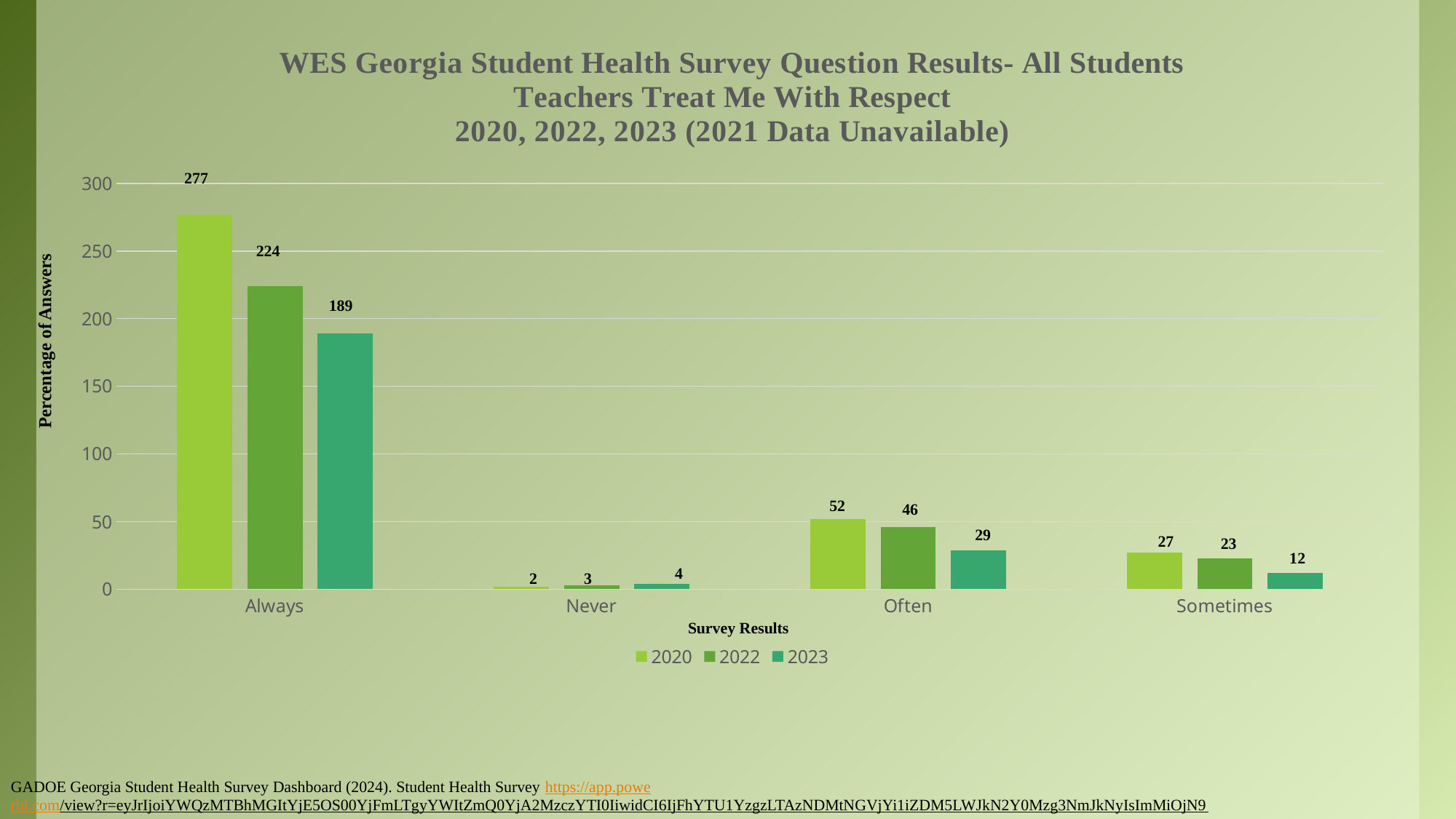
Which is larger: the 2022 value for Often or the 2020 value for Sometimes? 2022 value for Often What is the value for 2022 in the Sometimes category? 23 What kind of chart is shown on the slide? Bar chart Do the values for the Always category rise or fall from 2020 to 2023? Fall What is the value for 2023 in the Often category? 29 Which category has the highest value for 2023? Always How many series does the legend list? 3 Which category has the lowest value for 2020? Never How many categories are shown on the x axis? 4 What is the difference between the 2020 and 2023 values in the Always category? 88 What is the label of the x axis? Survey Results What is the value for 2020 in the Always category? 277